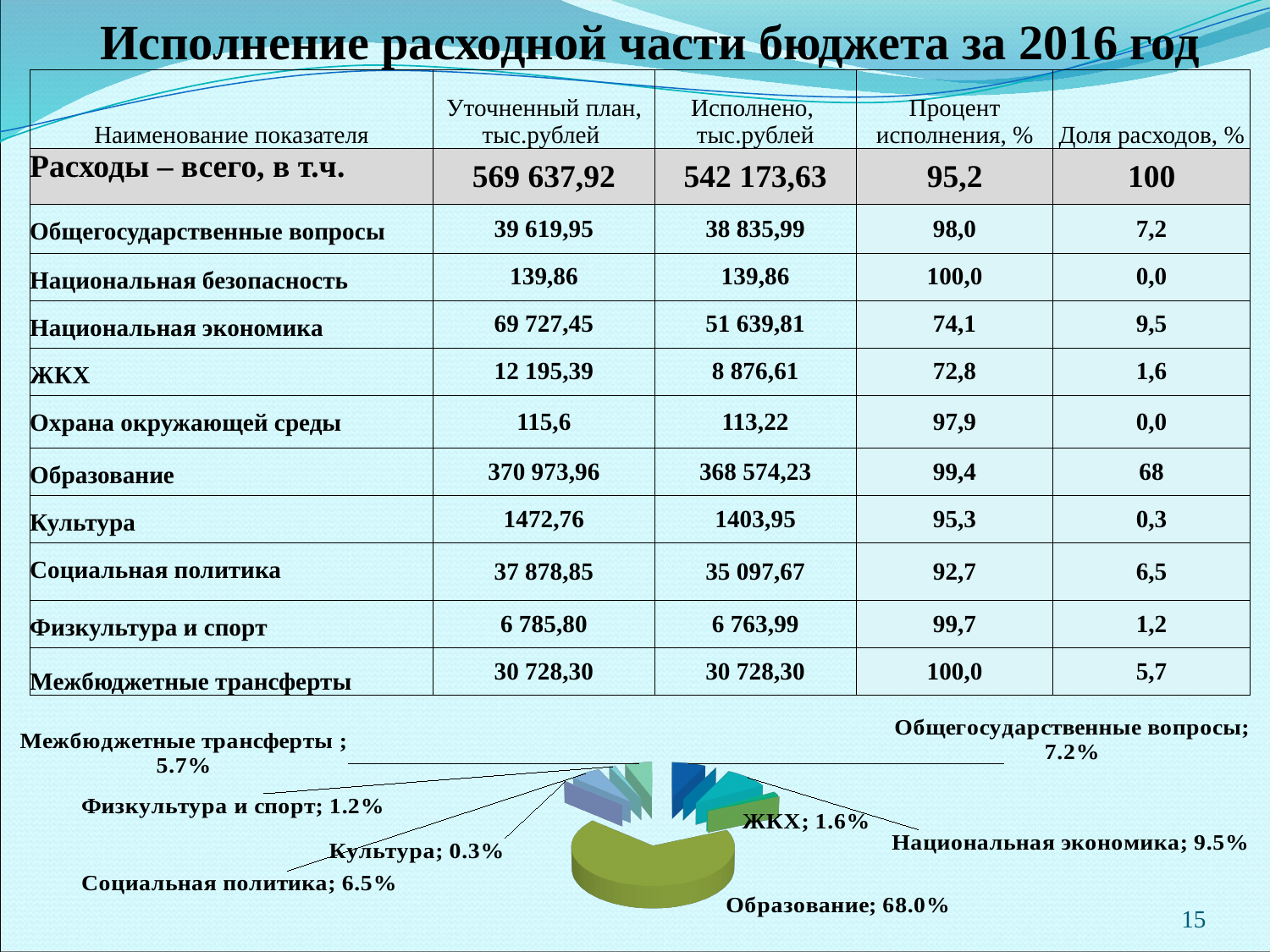
In the pie chart, what share is shown for ЖКХ? 1.6% In the pie chart, what is the difference between the shares of Национальная экономика and Общегосударственные вопросы? 2.3% Which category has the largest slice in the pie chart? Образование Which labelled category has the smallest slice in the pie chart? Культура In the pie chart, what is the combined share of Физкультура и спорт and Культура? 1.5% In the pie chart, which is larger: Общегосударственные вопросы or Социальная политика? Общегосударственные вопросы In the pie chart, what share is shown for Образование? 68.0% In the pie chart, what share is shown for Социальная политика? 6.5% How many labelled slices does the pie chart have? 8 In the pie chart, what share is shown for Национальная экономика? 9.5% What kind of chart is shown at the bottom of the slide? pie chart In the pie chart, what share is shown for Межбюджетные трансферты? 5.7%